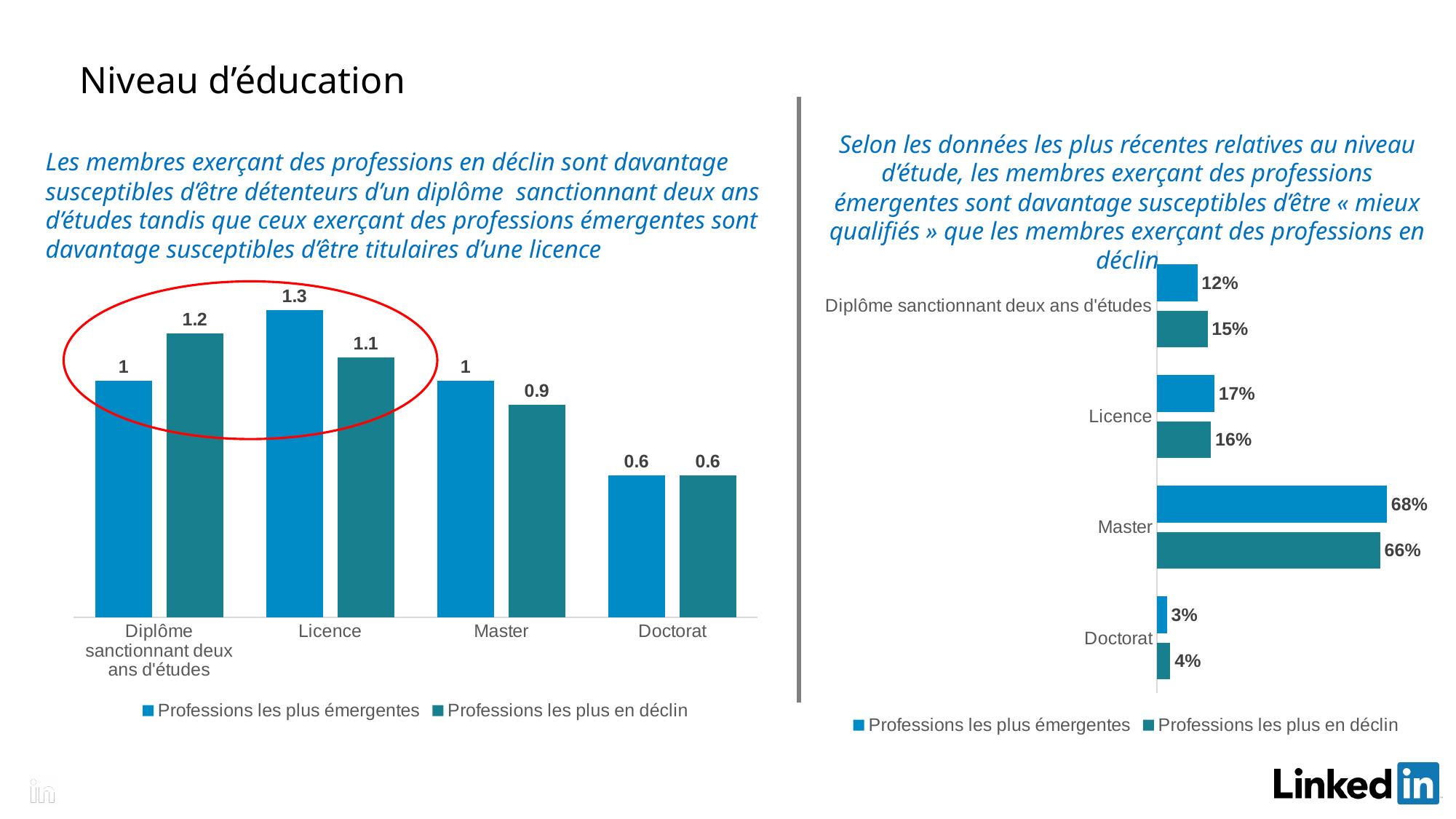
In the right chart, which category has the lowest value for 'Professions les plus émergentes'? Doctorat In the right chart, which series has the larger value for Licence? Professions les plus émergentes In the left chart, which category has the highest value for 'Professions les plus émergentes'? Licence In the right chart, what is the difference between the two series for 'Diplôme sanctionnant deux ans d'études'? 3% In the left chart, what is the difference between the two series for Master? 0.1 In the right chart, what is the value for Master in the 'Professions les plus émergentes' series? 68% In the left chart, how many categories are shown on the x axis? 4 In the left chart, what is the value for 'Diplôme sanctionnant deux ans d'études' in the 'Professions les plus en déclin' series? 1.2 In the right chart, what is the value for Doctorat in the 'Professions les plus en déclin' series? 4% What type of chart is the left chart? Bar chart In the left chart, what is the value for Licence in the 'Professions les plus émergentes' series? 1.3 How many series does the legend of the right chart list? 2